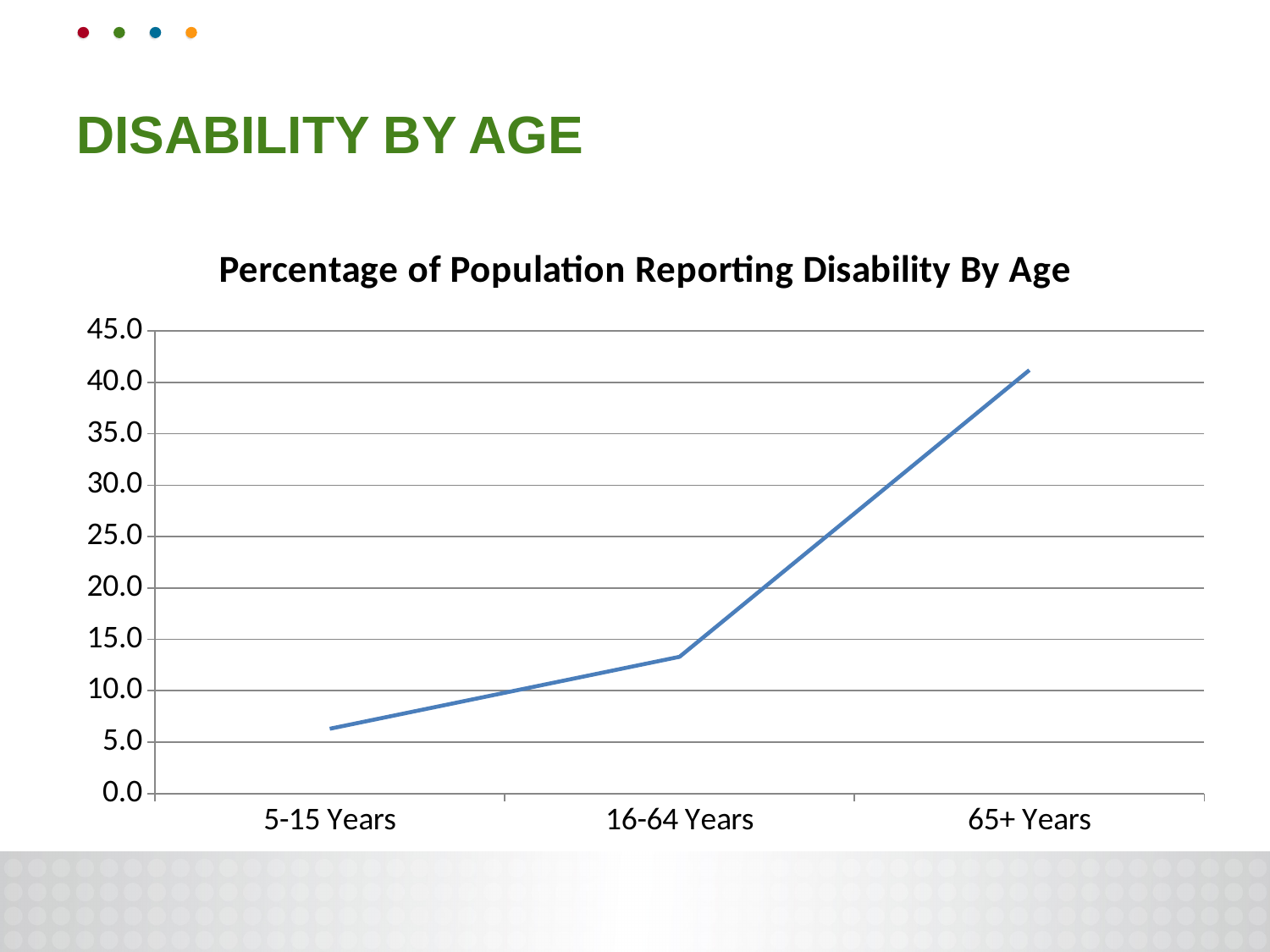
Is the value for 16-64 Years greater or less than 10.0? greater What is the title of the chart? Percentage of Population Reporting Disability By Age Is the value for 65+ Years greater or less than 35.0? greater What type of chart is shown on the slide? line chart Is the value for 5-15 Years greater or less than 10.0? less How many age categories are plotted on the x axis? 3 What is the maximum value shown on the y axis? 45.0 Which age group has the lowest percentage reporting disability? 5-15 Years Which age group has the highest percentage reporting disability? 65+ Years Do the values rise or fall moving from 5-15 Years to 65+ Years? rise Which is larger, the value for 16-64 Years or the value for 5-15 Years? 16-64 Years